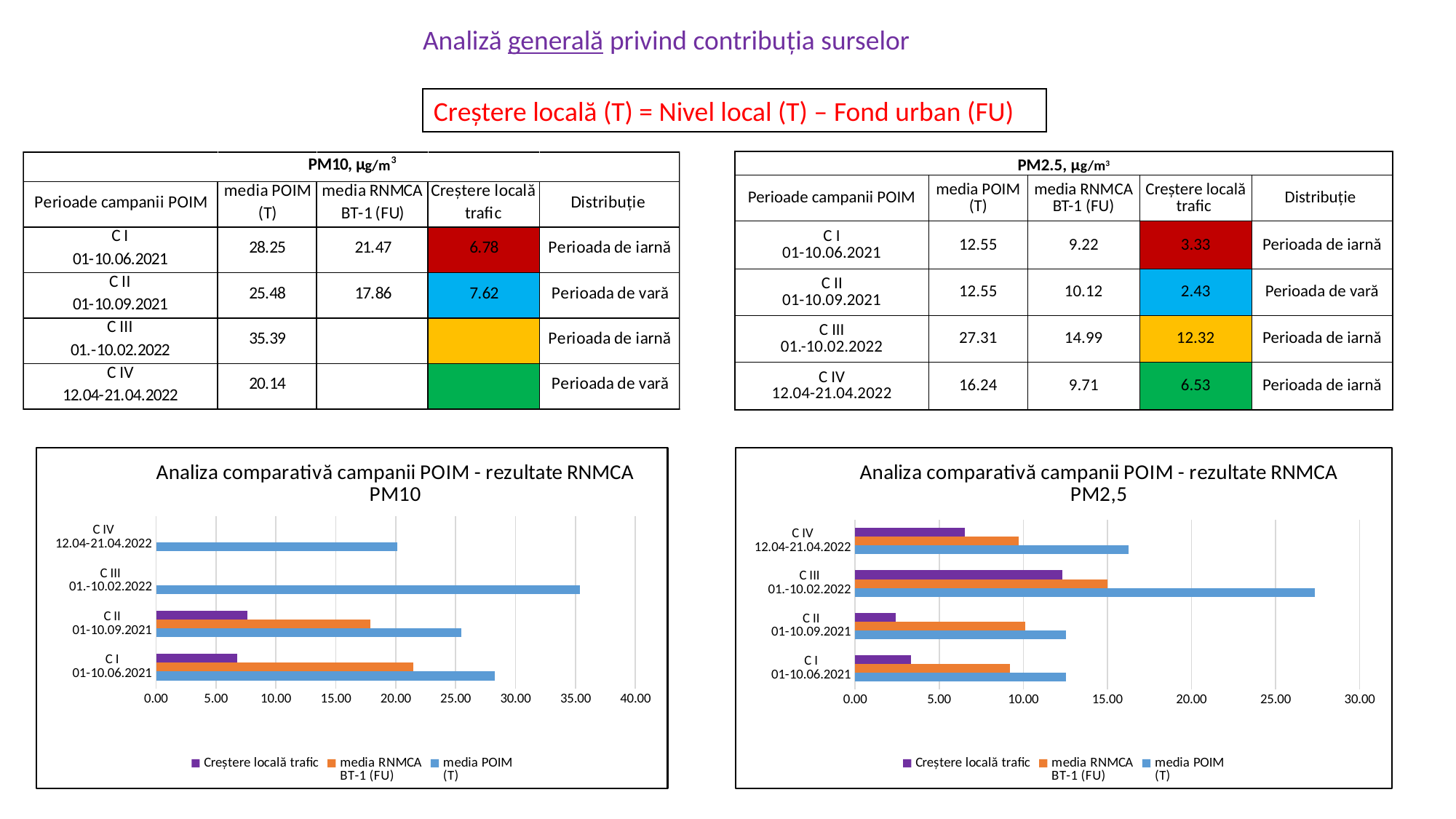
In the PM10 chart, which series is drawn in purple? Creștere locală trafic What is the title of the chart on the left of the slide? Analiza comparativă campanii POIM - rezultate RNMCA PM10 In the PM2,5 chart, which campaign has the highest 'Creștere locală trafic' value? C III 01.-10.02.2022 In the PM2,5 chart, which is larger: the 'Creștere locală trafic' value for C I 01-10.06.2021 or for C IV 12.04-21.04.2022? C IV 12.04-21.04.2022 How many campaign categories are shown on the y axis of the PM10 chart? 4 In the PM2,5 chart, which campaign has the highest 'media POIM (T)' value? C III 01.-10.02.2022 In the PM2,5 chart, is the 'Creștere locală trafic' value for C II 01-10.09.2021 greater or less than 5.00? less In the PM10 chart, which is larger: the 'media RNMCA BT-1 (FU)' value for C I 01-10.06.2021 or for C II 01-10.09.2021? C I 01-10.06.2021 How many series does the legend of the 'Analiza comparativă campanii POIM - rezultate RNMCA PM2,5' chart list? 3 In the PM10 chart, is the 'media POIM (T)' value for C III 01.-10.02.2022 greater or less than 30.00? greater In the PM10 chart, which campaign has the lowest 'media POIM (T)' value? C IV 12.04-21.04.2022 What kind of chart is the 'Analiza comparativă campanii POIM - rezultate RNMCA PM10' chart? bar chart